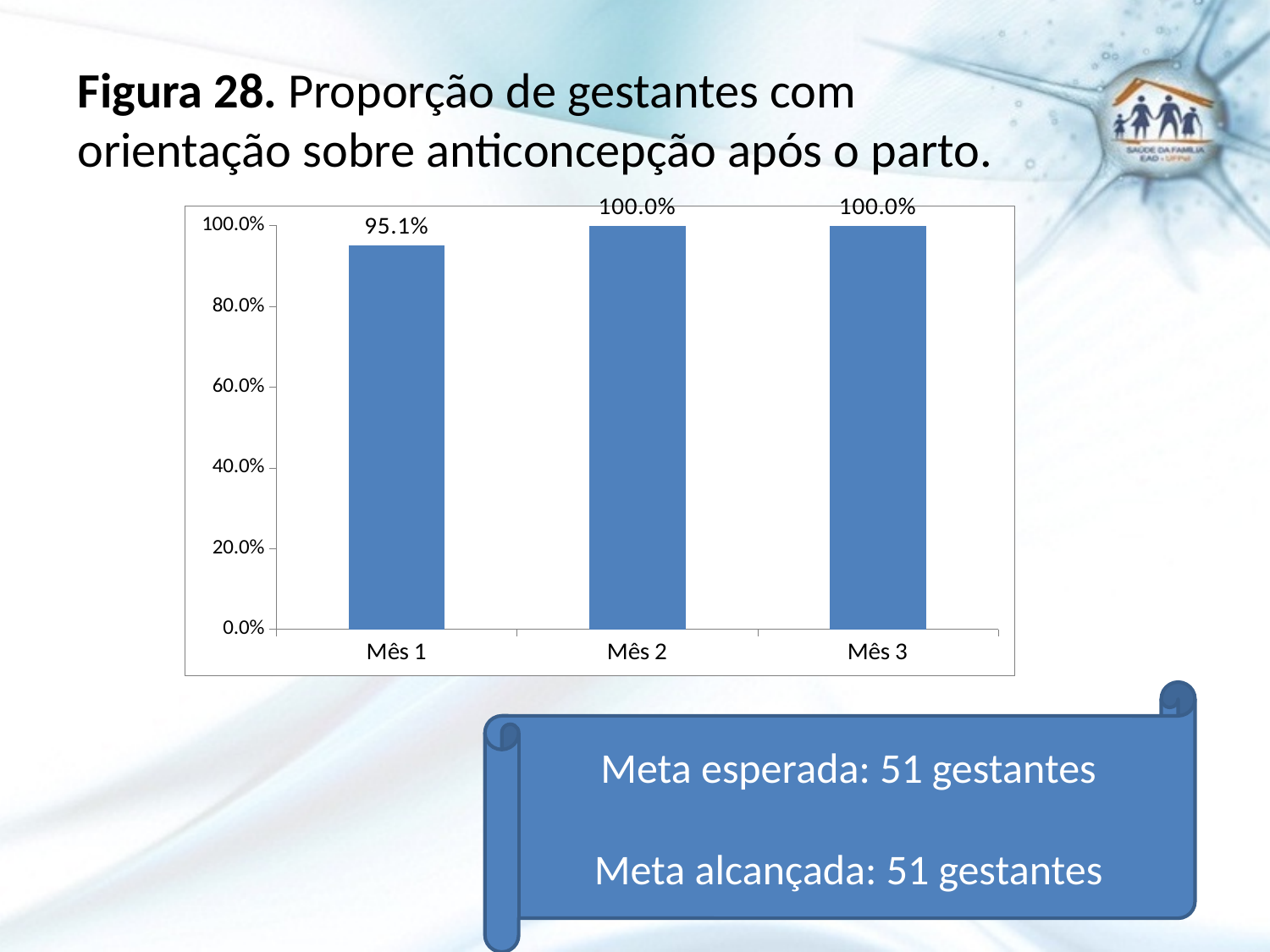
Which is larger, the value for Mês 1 or the value for Mês 3? Mês 3 How many categories are shown on the x axis? 3 What is the difference between the values for Mês 2 and Mês 1? 4.9% What colour are the bars in the chart? blue What kind of chart is shown on the slide? bar chart What is the value for Mês 3? 100.0% What is the value for Mês 2? 100.0% What is the value for Mês 1? 95.1% Do the values rise or fall from Mês 1 to Mês 2? rise What is the figure number given in the slide title? Figura 28 Is the value for Mês 1 greater or less than 80.0%? greater Which month has the lowest value? Mês 1